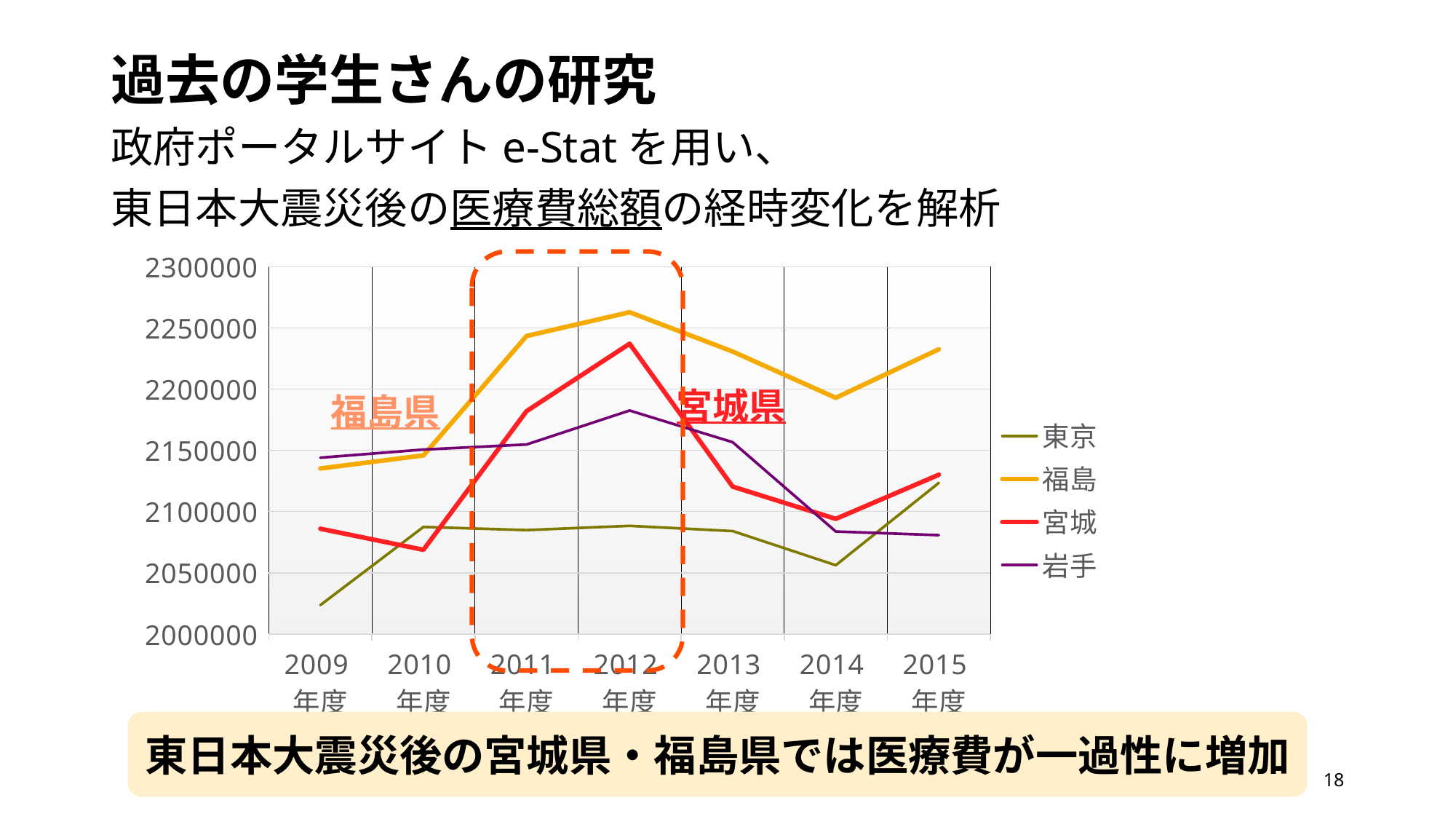
Which entries are listed in the legend? 東京, 福島, 宮城, 岩手 In which fiscal year does the 宮城 series reach its peak? 2012年度 What kind of chart is shown on the slide? line chart In 2012年度, which is larger, the value for 宮城 or the value for 岩手? 宮城 Which series has the highest value in 2012年度? 福島 Does the value for 福島 rise or fall from 2012年度 to 2014年度? fall How many fiscal years are plotted along the x axis? 7 Is the value for 宮城 in 2010年度 greater or less than 2100000? less Which series has the lowest value in 2009年度? 東京 Is the value for 福島 in 2012年度 greater or less than 2250000? greater How many series does the legend list? 4 Is the value for 東京 in 2009年度 greater or less than 2050000? less